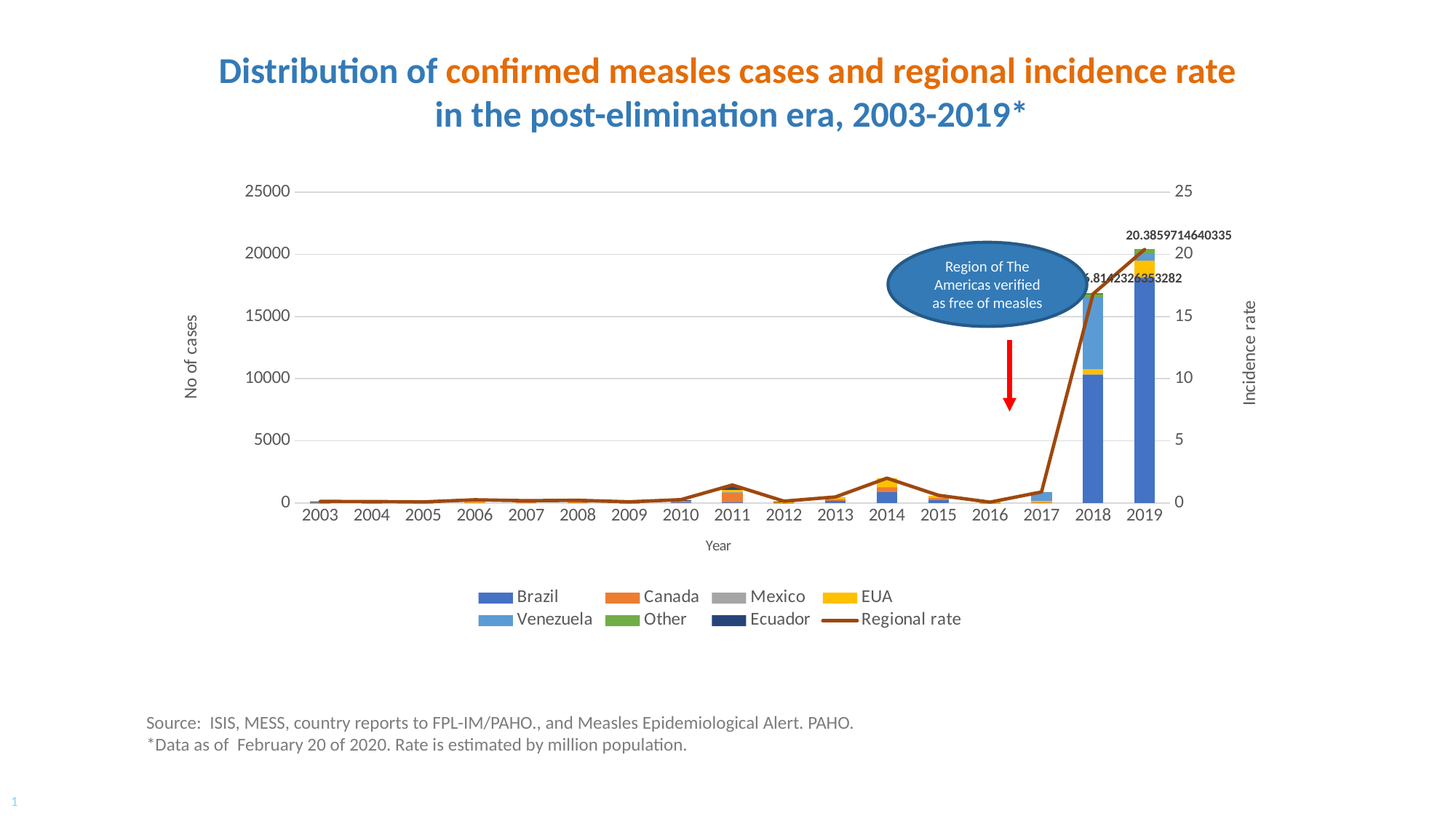
Is the total number of cases in 2018 greater or less than 15000? greater Which year has the highest number of confirmed measles cases? 2019 How many series does the legend list? 8 What kind of chart is shown on the slide? A bar chart with a line Which series makes up most of the 2019 bar? Brazil Which year has more confirmed cases, 2011 or 2014? 2014 What is the regional incidence rate labelled for 2019? 20.3859714640335 Is the regional rate for 2018 greater or less than 15? greater Is the total number of cases in 2017 greater or less than 5000? less Does the regional rate rise or fall from 2016 to 2019? rise What is the title of the left vertical axis? No of cases How many years are shown on the x axis? 17